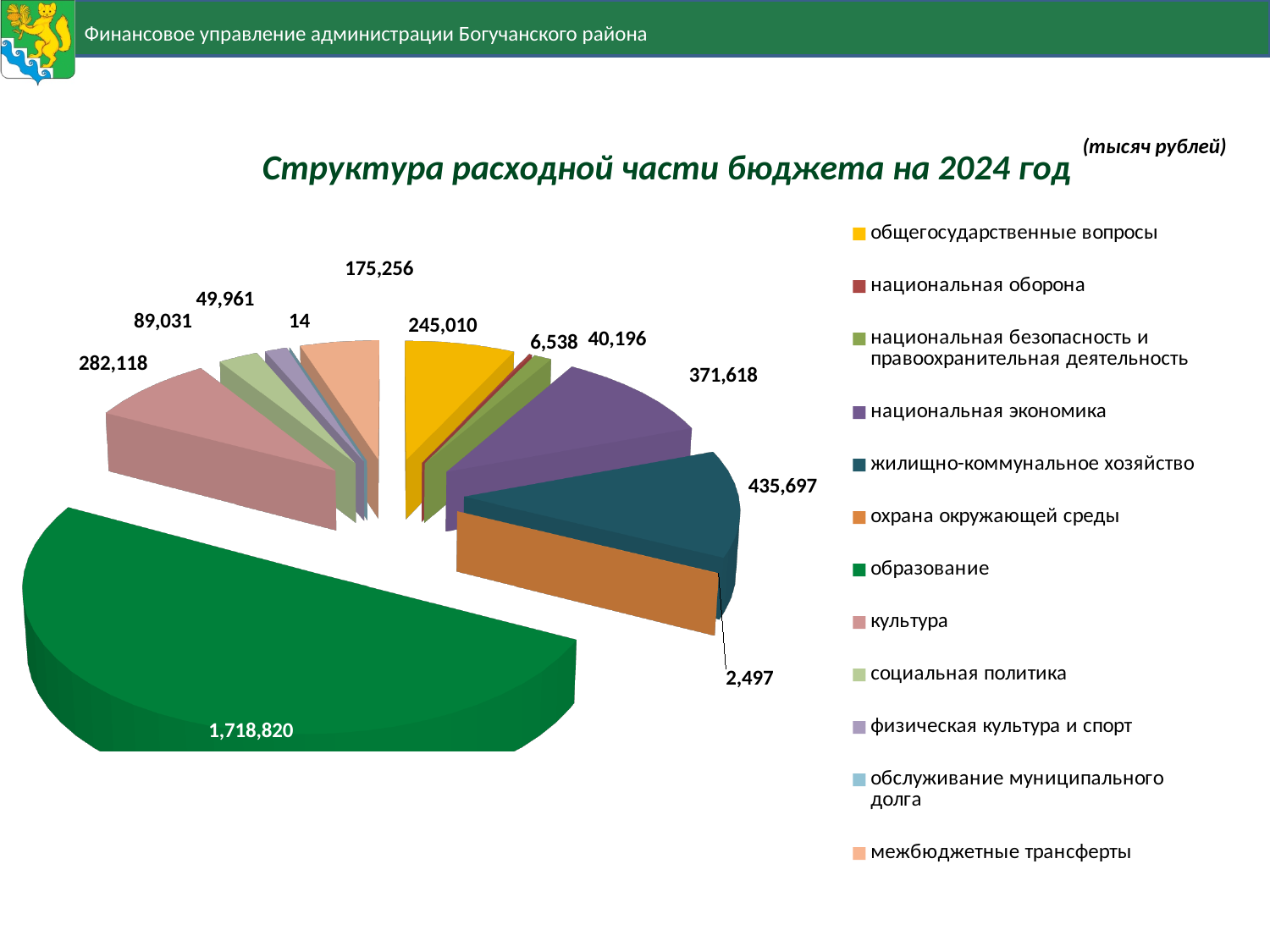
What is the difference between the values for культура and социальная политика? 193,087 Which category has the largest slice in the pie chart? образование How many categories does the pie chart show? 12 What is the value for физическая культура и спорт? 49,961 In what units are the values on the chart given, according to the note next to the title? тысяч рублей What is the value for национальная экономика? 371,618 What is the value for образование? 1,718,820 Which category has the smallest value in the pie chart? обслуживание муниципального долга What is the value for культура? 282,118 Which is larger: общегосударственные вопросы or межбюджетные трансферты? общегосударственные вопросы What kind of chart is shown on the slide? pie chart What is the difference between the values for жилищно-коммунальное хозяйство and национальная экономика? 64,079